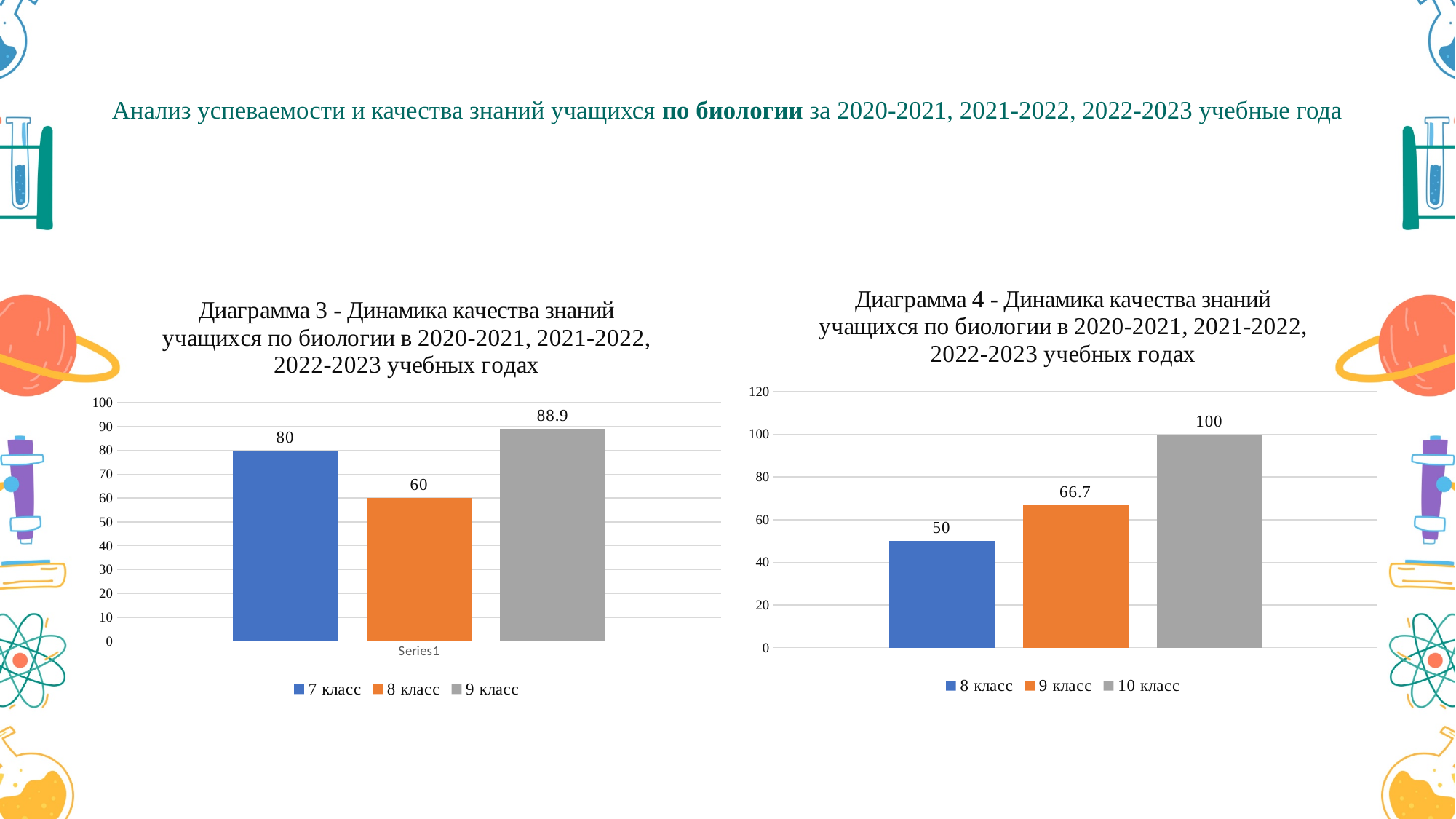
In Диаграмма 3 (left chart), what is the value for 7 класс? 80 In Диаграмма 4 (right chart), what is the value for 10 класс? 100 In Диаграмма 4 (right chart), which series has the highest value? 10 класс In Диаграмма 4 (right chart), what is the value for 9 класс? 66.7 In Диаграмма 3 (left chart), what is the value for 9 класс? 88.9 In Диаграмма 3 (left chart), how many series does the legend list? 3 In Диаграмма 4 (right chart), which is larger: the value for 8 класс or the value for 9 класс? 9 класс In Диаграмма 4 (right chart), what is the difference between the values for 10 класс and 8 класс? 50 In Диаграмма 4 (right chart), what colour is the bar for 10 класс? Grey What kind of chart is Диаграмма 4 (right chart)? Bar chart In Диаграмма 3 (left chart), what is the difference between the values for 9 класс and 8 класс? 28.9 In Диаграмма 3 (left chart), which series has the lowest value? 8 класс